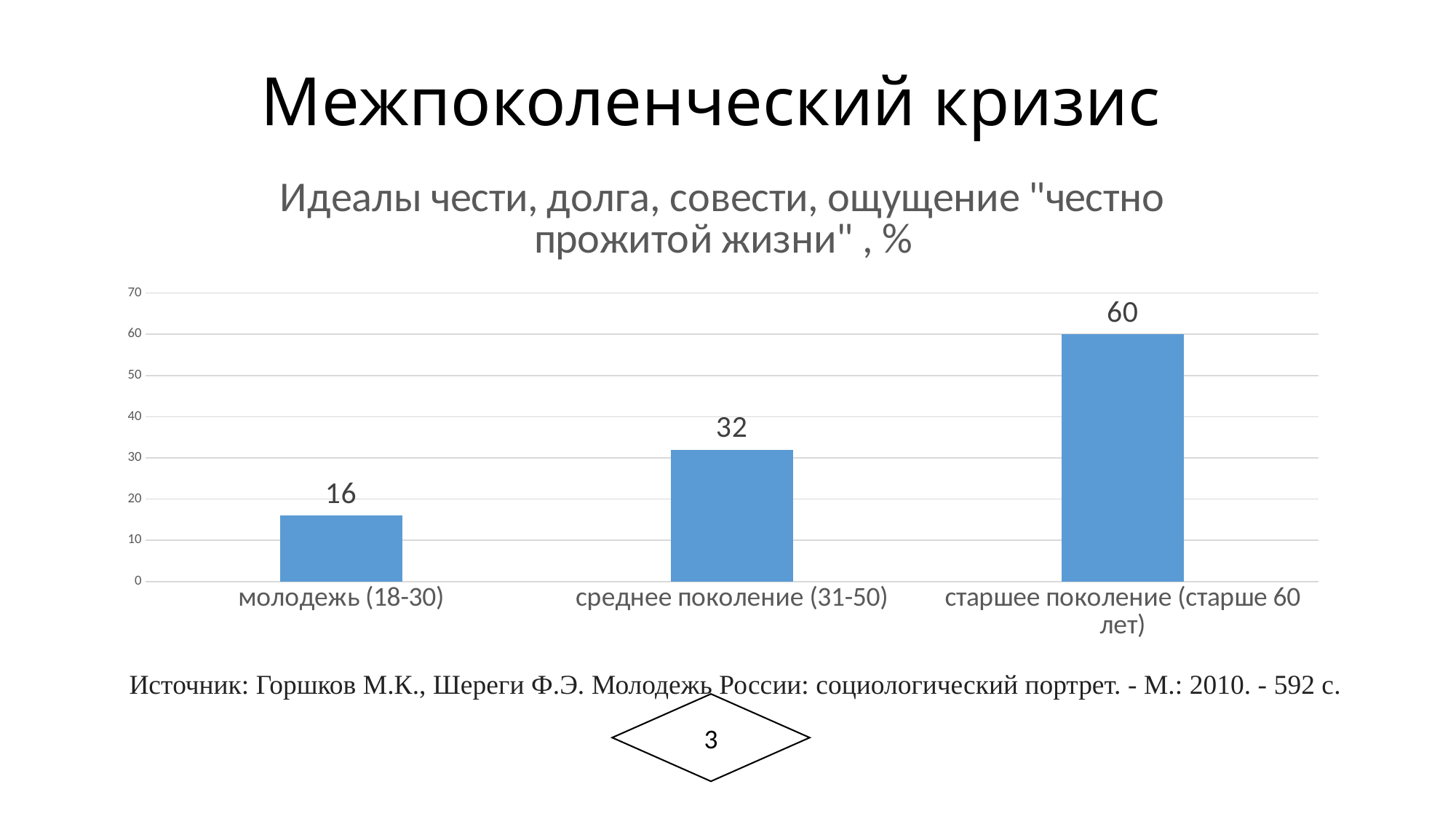
What is the value for молодежь (18-30)? 16 What is the value for среднее поколение (31-50)? 32 Which is larger: the value for среднее поколение (31-50) or the value for молодежь (18-30)? среднее поколение (31-50) What is the difference between the values for среднее поколение (31-50) and молодежь (18-30)? 16 What kind of chart is shown on the slide? bar chart Is the value for старшее поколение (старше 60 лет) greater or less than 50? greater Do the values rise or fall from left to right across the categories? rise What is the difference between the values for старшее поколение (старше 60 лет) and молодежь (18-30)? 44 Which category has the highest value? старшее поколение (старше 60 лет) What is the value for старшее поколение (старше 60 лет)? 60 Which category has the lowest value? молодежь (18-30) How many categories are shown in the chart? 3